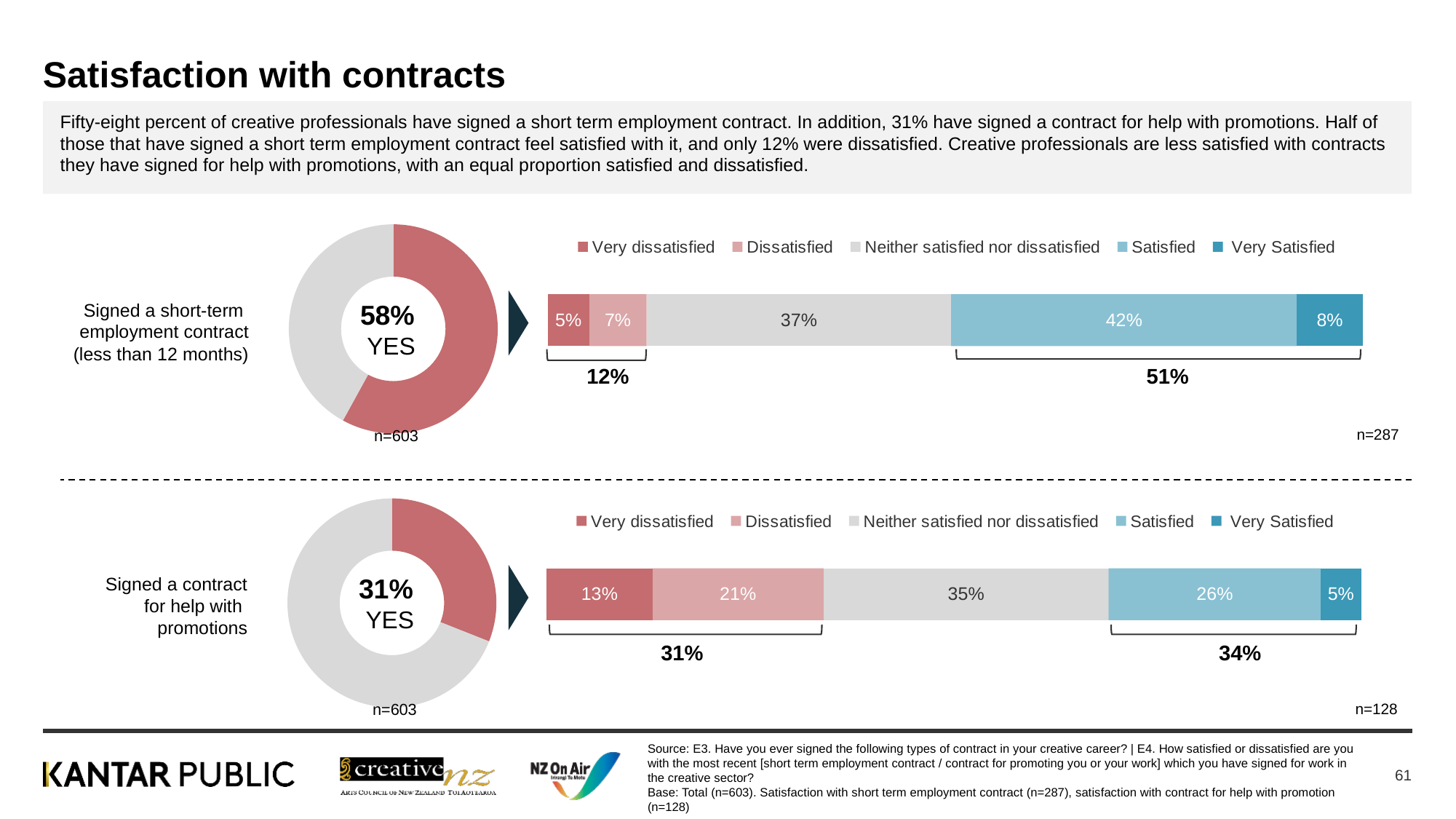
How many series does the legend of the top stacked bar chart list? 5 In the bottom donut chart, what percentage have signed a contract for help with promotions? 31% In the bottom stacked bar for the contract for help with promotions, what is the difference between 'Satisfied' and 'Very Satisfied'? 21% In the bottom stacked bar for the contract for help with promotions, what is the value for 'Dissatisfied'? 21% What is the combined satisfied share (Satisfied plus Very Satisfied) shown under the top stacked bar for the short-term employment contract? 51% In the top stacked bar for the short-term employment contract, which category has the lowest value? Very dissatisfied In the top stacked bar for the short-term employment contract, what is the value for 'Satisfied'? 42% In the top donut chart, what percentage of creative professionals have signed a short-term employment contract (less than 12 months)? 58% In the top stacked bar for the short-term employment contract, what is the value for 'Very dissatisfied'? 5% What kind of chart shows the 58% YES figure for the short-term employment contract? Donut chart Comparing the two stacked bars, which contract type has the larger 'Very dissatisfied' value: the short-term employment contract or the contract for help with promotions? Contract for help with promotions In the bottom stacked bar for the contract for help with promotions, which category has the highest value? Neither satisfied nor dissatisfied